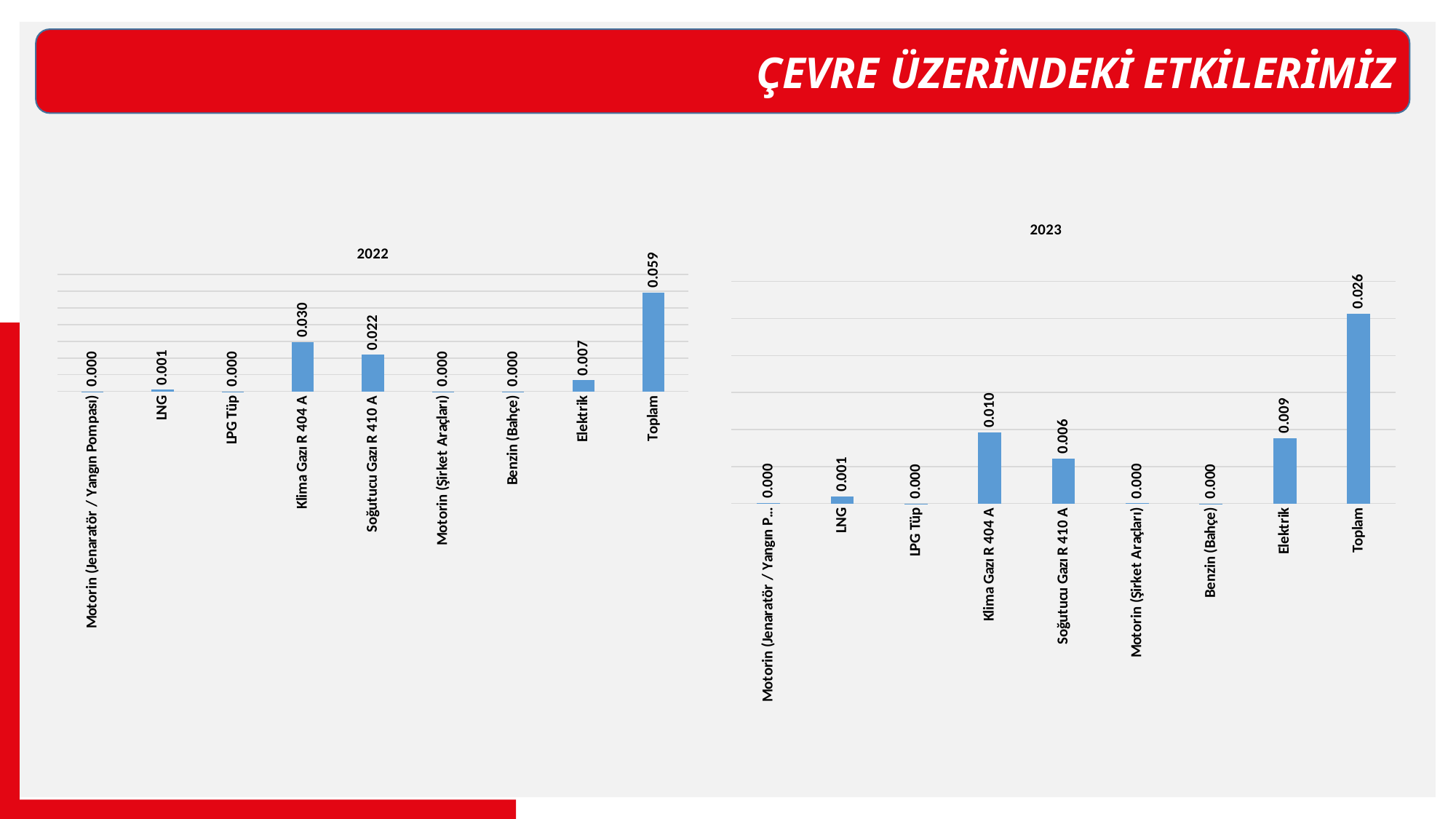
What type of chart is the 2023 chart? Bar chart What is the difference between the Toplam value in the 2022 chart and the Toplam value in the 2023 chart? 0.033 In the 2022 chart, which category other than Toplam has the highest value? Klima Gazı R 404 A In the 2023 chart, which category has the highest value? Toplam In the 2023 chart, which is larger: Klima Gazı R 404 A or Elektrik? Klima Gazı R 404 A How many categories are shown in the 2022 chart? 9 In the 2022 chart, what is the difference between Klima Gazı R 404 A and Soğutucu Gazı R 410 A? 0.008 In the 2022 chart, what is the value for Toplam? 0.059 In the 2023 chart, what is the value for Soğutucu Gazı R 410 A? 0.006 In the 2022 chart, what is the value for Klima Gazı R 404 A? 0.030 What is the title of the chart on the left side of the slide? 2022 In the 2023 chart, what is the value for Elektrik? 0.009